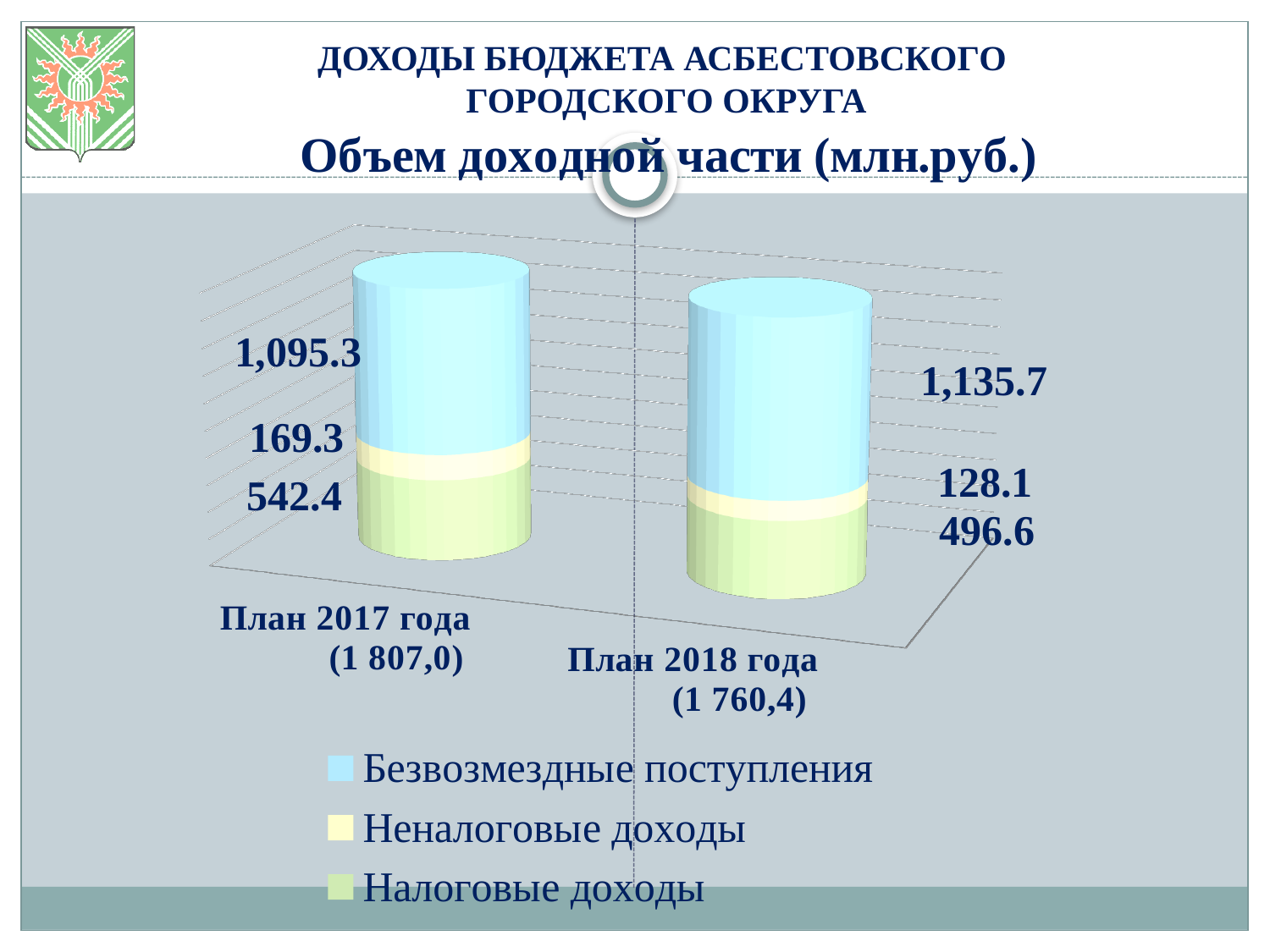
How many categories are shown on the x axis? 2 Which is larger: Неналоговые доходы for План 2017 года or for План 2018 года? План 2017 года What is the difference between Налоговые доходы for План 2017 года and План 2018 года? 45.8 What kind of chart is shown on the slide? Stacked bar chart How many series does the legend list? 3 Which legend entry is shown in blue? Безвозмездные поступления What is the total of the stacked bar for План 2018 года? 1 760,4 What is the value of Неналоговые доходы for План 2018 года? 128.1 What is the value of Безвозмездные поступления for План 2017 года? 1,095.3 What is the value of Безвозмездные поступления for План 2018 года? 1,135.7 What is the value of Налоговые доходы for План 2017 года? 542.4 What is the difference between Безвозмездные поступления for План 2018 года and План 2017 года? 40.4